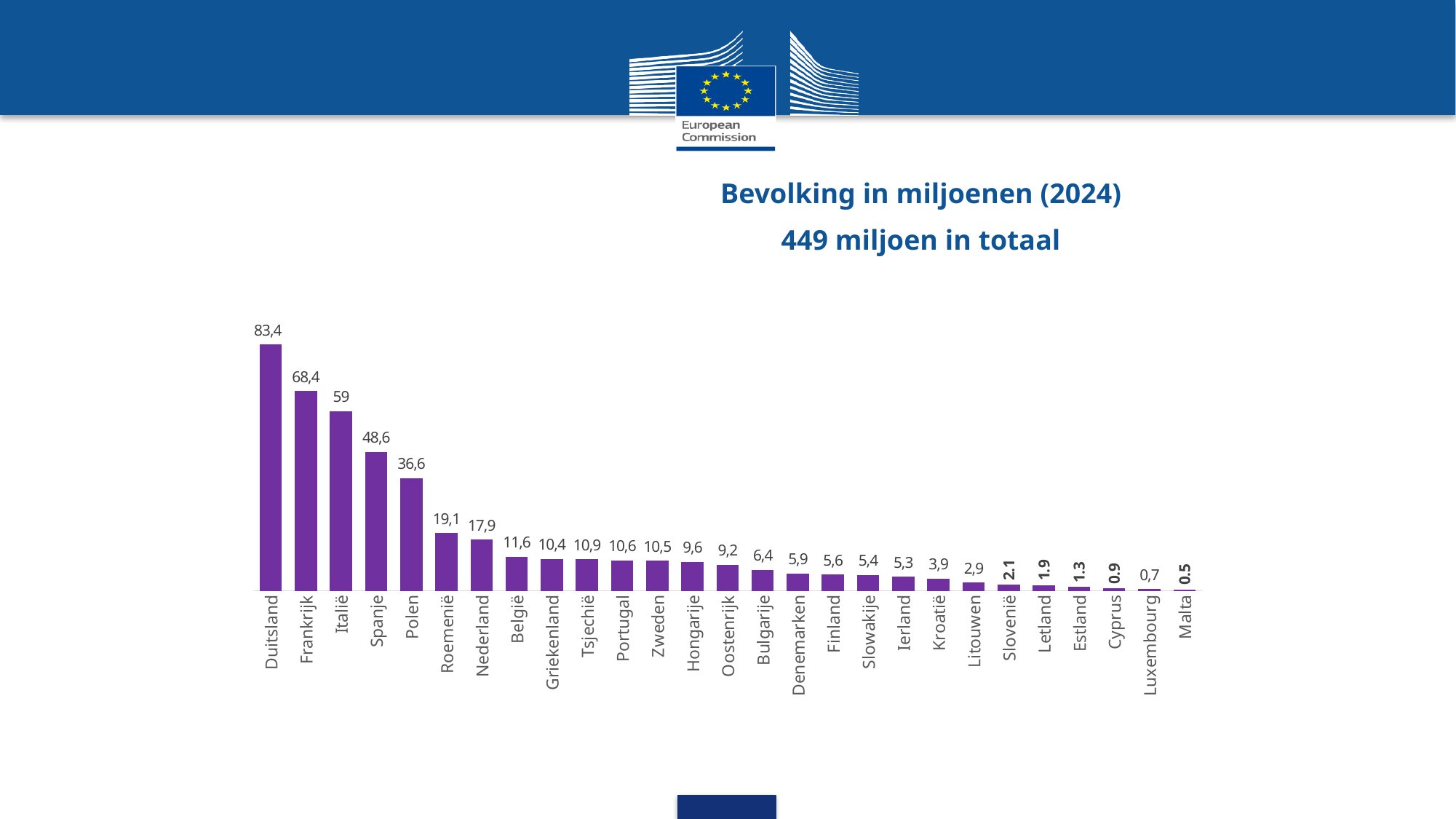
What is the difference between the values for Duitsland and Frankrijk? 15 What value is shown for Luxembourg? 0,7 What value is shown for Nederland? 17,9 What kind of chart is shown on the slide? Bar chart Which has a larger value, Tsjechië or Griekenland? Tsjechië Which has a larger value, Spanje or Polen? Spanje Which country has the lowest value in the chart? Malta What is the title of the chart? Bevolking in miljoenen (2024) How many countries are shown in the chart? 27 Which country has the highest value in the chart? Duitsland What is the population value shown for Duitsland? 83,4 What is the difference between the values for Nederland and België? 6,3